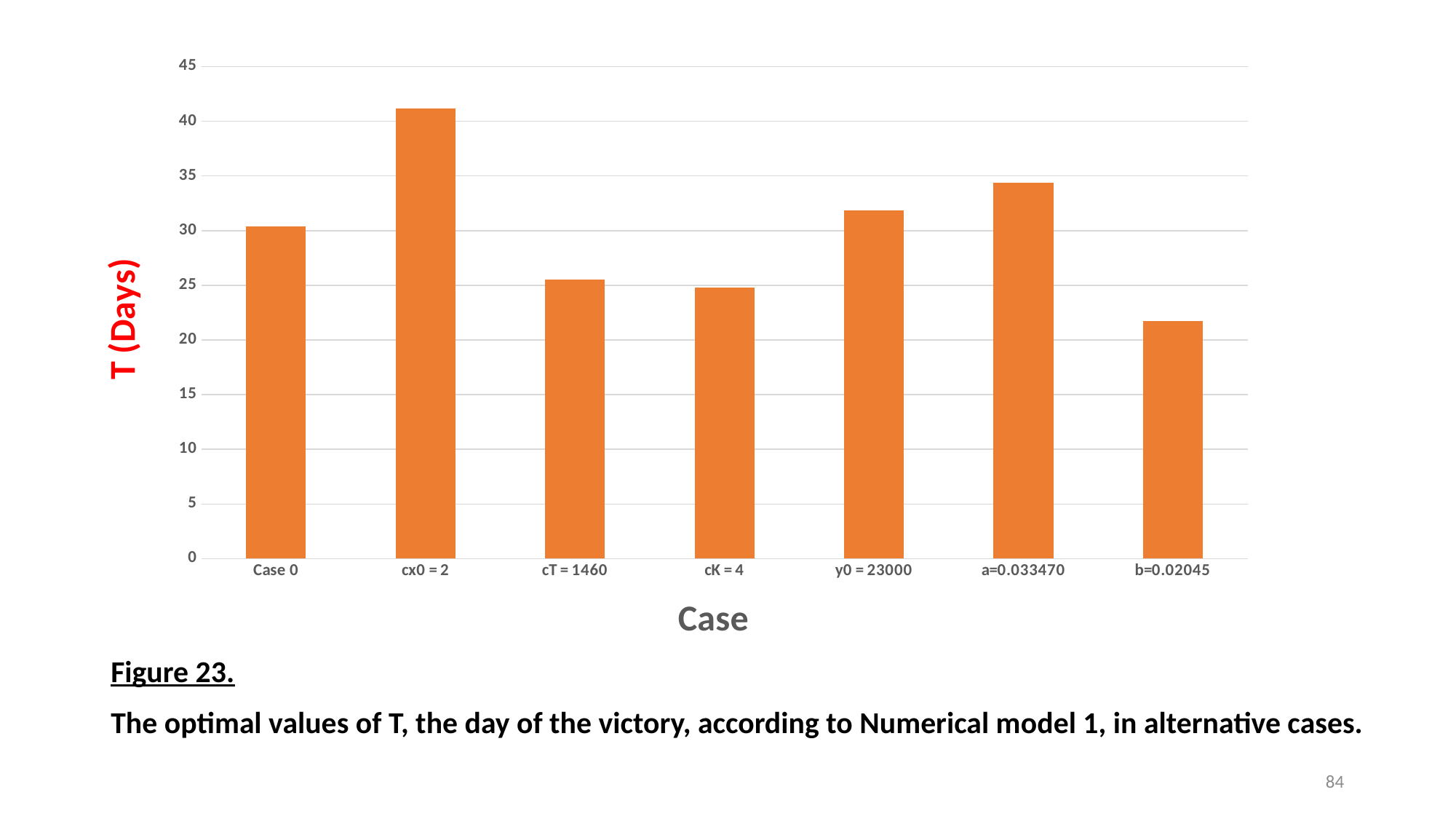
Is the value of T for b=0.02045 greater or less than 20? greater Is the value of T for a=0.033470 greater or less than 35? less Which case has the highest value of T (Days)? cx0 = 2 Which has a larger value of T: a=0.033470 or y0 = 23000? a=0.033470 What is the label of the vertical axis? T (Days) How many cases (bars) are plotted on the chart? 7 What kind of chart is shown on the slide? bar chart Which case has the lowest value of T (Days)? b=0.02045 Which has a larger value of T: Case 0 or cT = 1460? Case 0 Is the value of T for cx0 = 2 greater or less than 40? greater